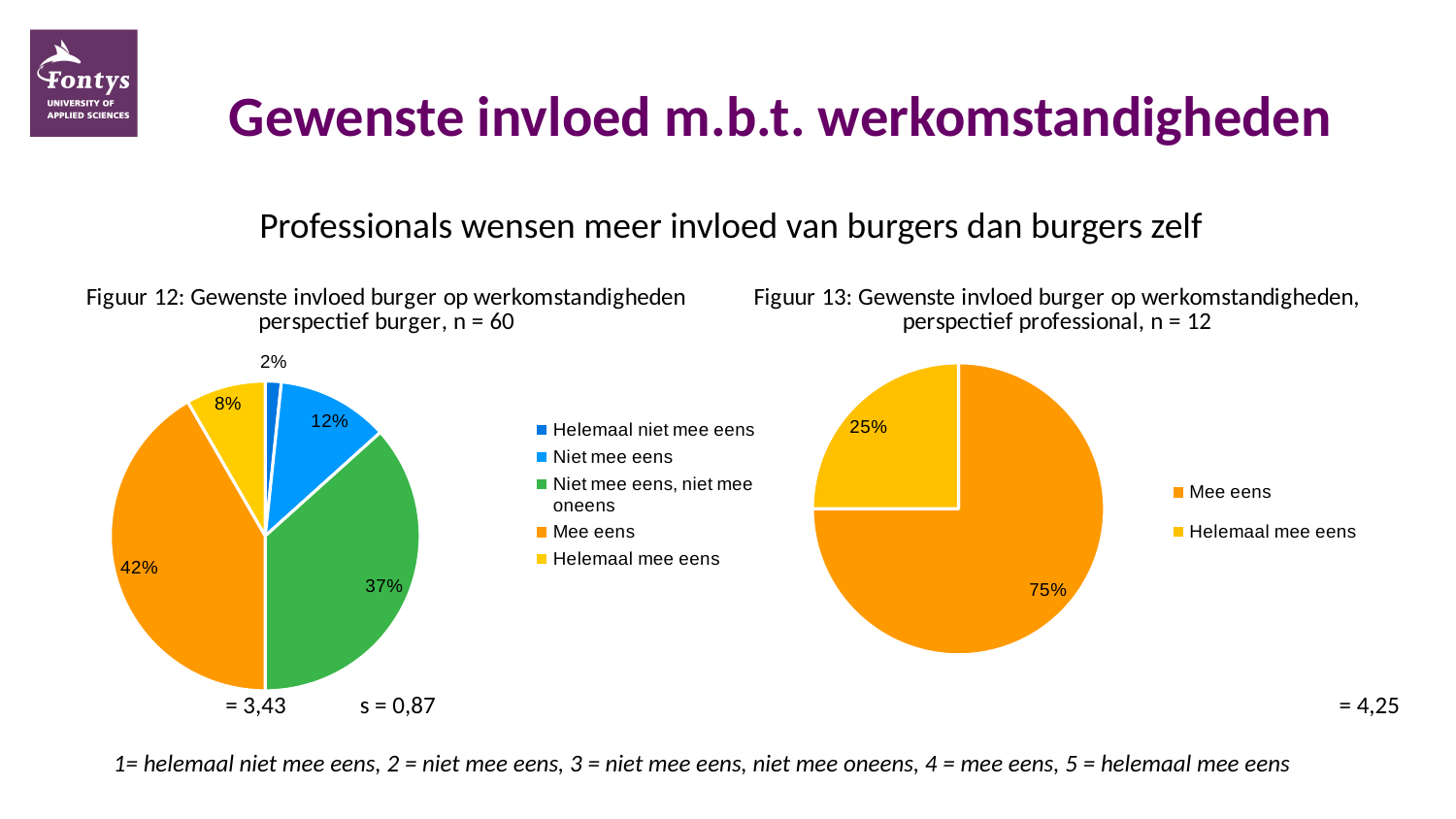
In Figuur 12 (perspectief burger), which answer category has the largest share? Mee eens In Figuur 12 (perspectief burger), what share of respondents answered "Helemaal niet mee eens"? 2% How many answer categories does the legend of Figuur 12 (perspectief burger) list? 5 In Figuur 12 (perspectief burger), what share of respondents answered "Mee eens"? 42% In Figuur 12 (perspectief burger), which answer category has the smallest share? Helemaal niet mee eens In Figuur 12 (perspectief burger), what is the difference in percentage points between "Mee eens" and "Niet mee eens, niet mee oneens"? 5 percentage points What type of chart is Figuur 13 (perspectief professional)? Pie chart In Figuur 13 (perspectief professional), which answer category has the largest share? Mee eens In Figuur 13 (perspectief professional), what share of respondents answered "Helemaal mee eens"? 25% In Figuur 12 (perspectief burger), which is larger: the share for "Niet mee eens" or the share for "Helemaal mee eens"? Niet mee eens In Figuur 12 (perspectief burger), what share of respondents answered "Niet mee eens, niet mee oneens"? 37% In Figuur 13 (perspectief professional), what is the difference in percentage points between "Mee eens" and "Helemaal mee eens"? 50 percentage points